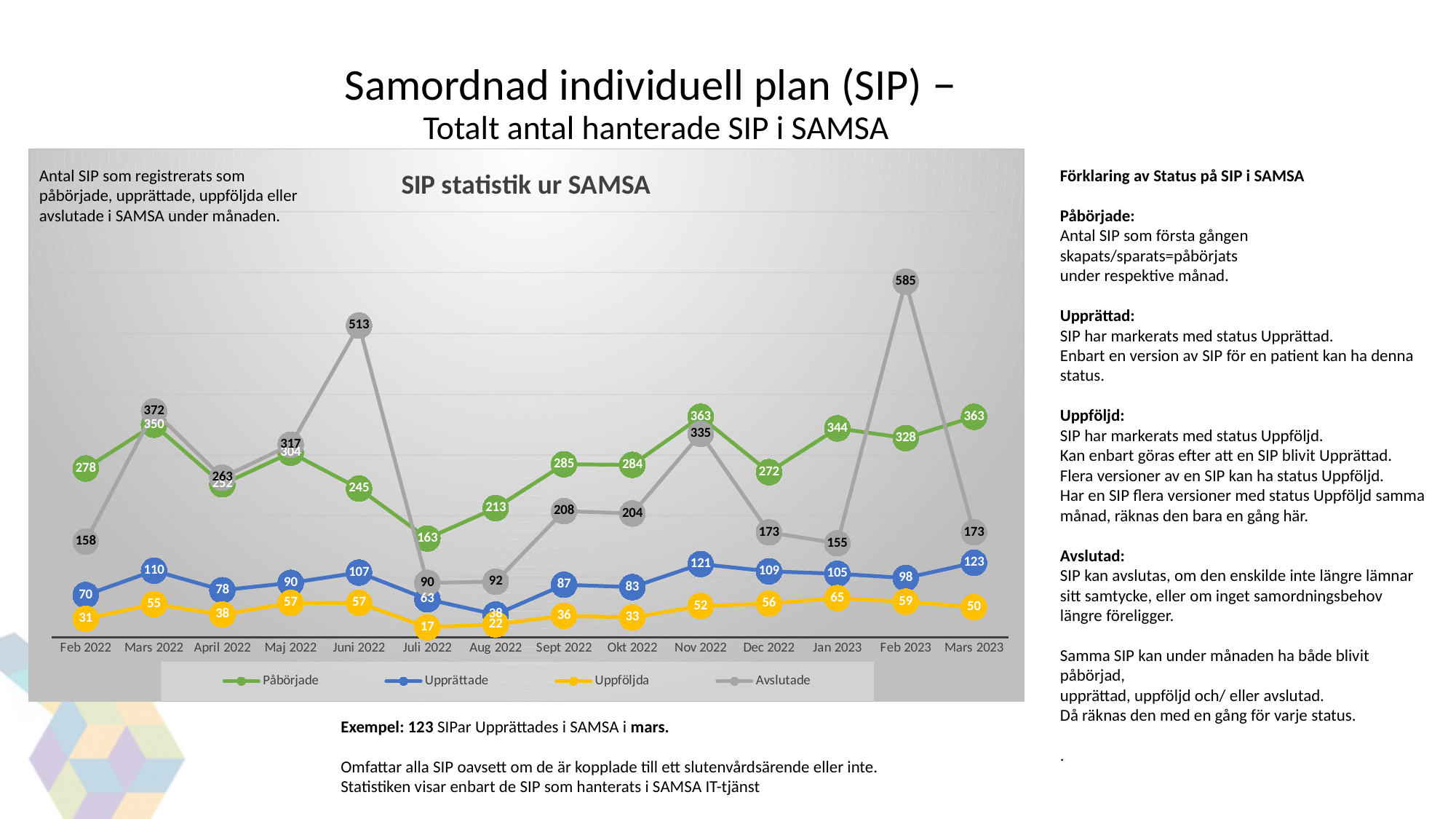
In which month is the Avslutade series highest? Feb 2023 How many months are plotted along the x axis of the chart? 14 What is the value for Uppföljda in Jan 2023? 65 What is the difference between the Påbörjade values for Mars 2023 and Feb 2023? 35 In which month is the Påbörjade series lowest? Juli 2022 In which month is the Uppföljda series lowest? Juli 2022 What kind of chart is shown on the slide? line chart What is the value for Avslutade in Feb 2023? 585 In Juni 2022, which is larger: Avslutade or Påbörjade? Avslutade How many series does the legend of the chart list? 4 What is the value for Upprättade in Mars 2023? 123 What colour is the Avslutade series in the chart? grey